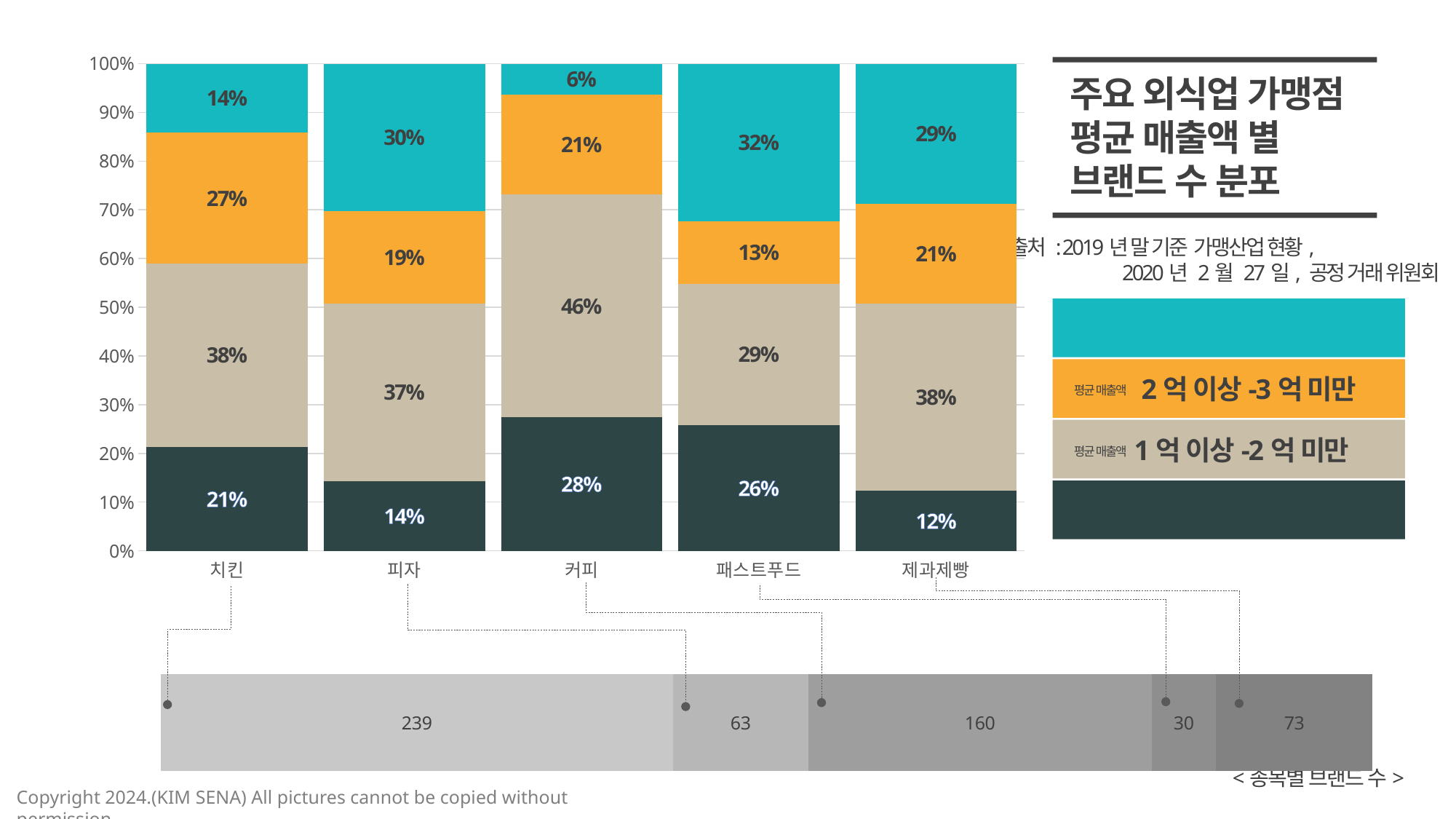
How many categories are shown on the x axis of the stacked bar chart? 5 What is the title of the chart? 주요 외식업 가맹점 평균 매출액 별 브랜드 수 분포 What kind of chart is the main chart on the slide? Stacked bar chart Which category has the smallest top (teal) segment? 커피 Which category has the largest share in the 1억 이상-2억 미만 band? 커피 Which has a larger share in the 2억 이상-3억 미만 band, 치킨 or 피자? 치킨 According to the 총 브랜드 수 bar at the bottom, how many 치킨 brands are there? 239 How many percentage points larger is the top (teal) segment for 패스트푸드 than for 치킨? 18 percentage points What percentage of 치킨 brands fall in the 평균 매출액 1억 이상-2억 미만 band? 38% What is the value of the bottom (dark) segment of the 피자 bar? 14% Which category has the highest total brand count in the bar at the bottom? 치킨 What percentage of 커피 brands fall in the 평균 매출액 2억 이상-3억 미만 band? 21%